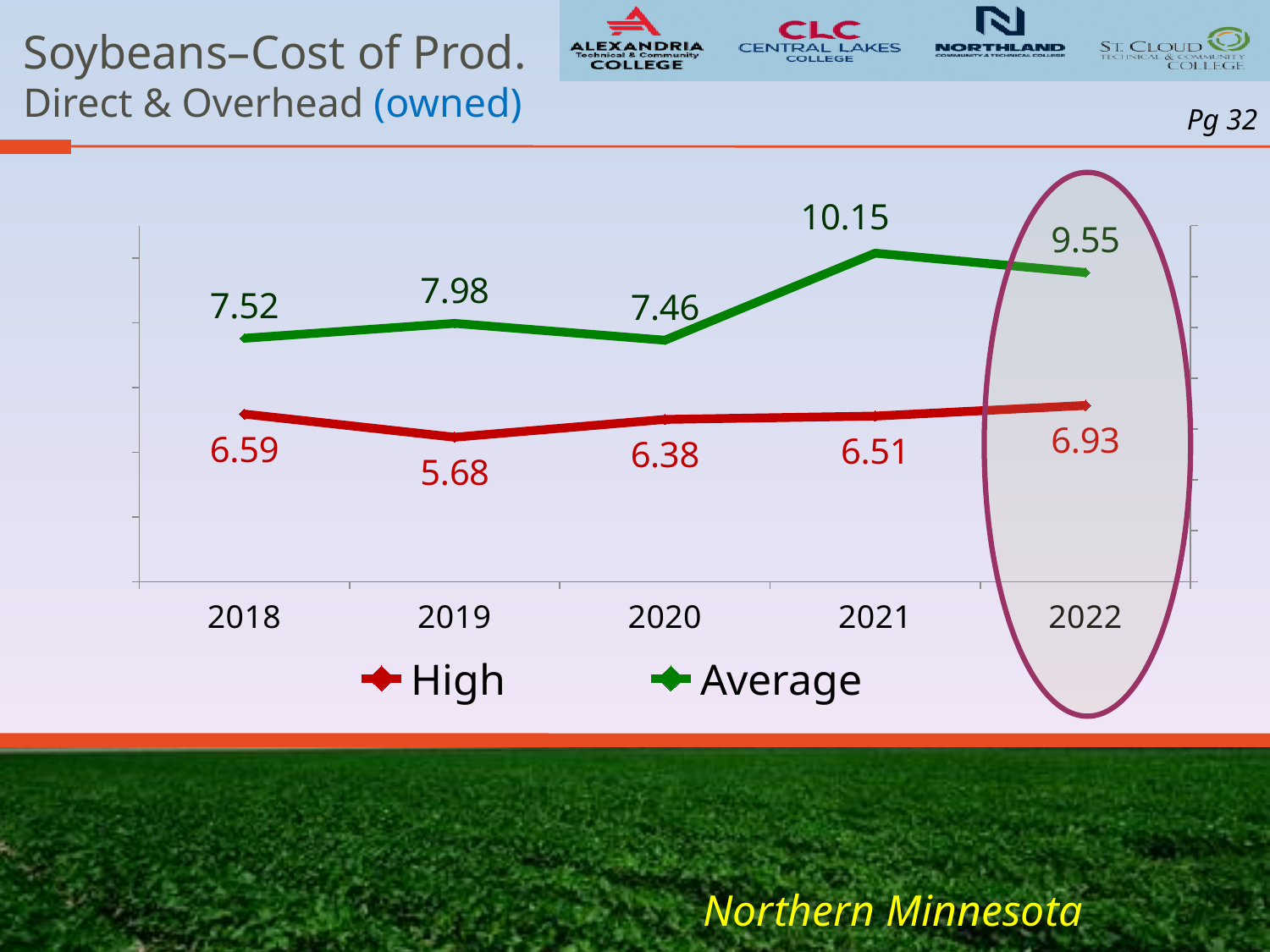
What kind of chart is shown on the slide? line chart What is the Average value for 2021? 10.15 How many years are shown on the x axis? 5 What is the High value for 2018? 6.59 Does the High series rise or fall from 2019 to 2022? rise In which year is the High series lowest? 2019 How many series does the legend list? 2 In which year is the Average series highest? 2021 What is the Average value for 2022? 9.55 What is the High value for 2019? 5.68 What is the difference between the Average and High values in 2022? 2.62 Which is larger, the Average value for 2020 or the Average value for 2019? 2019